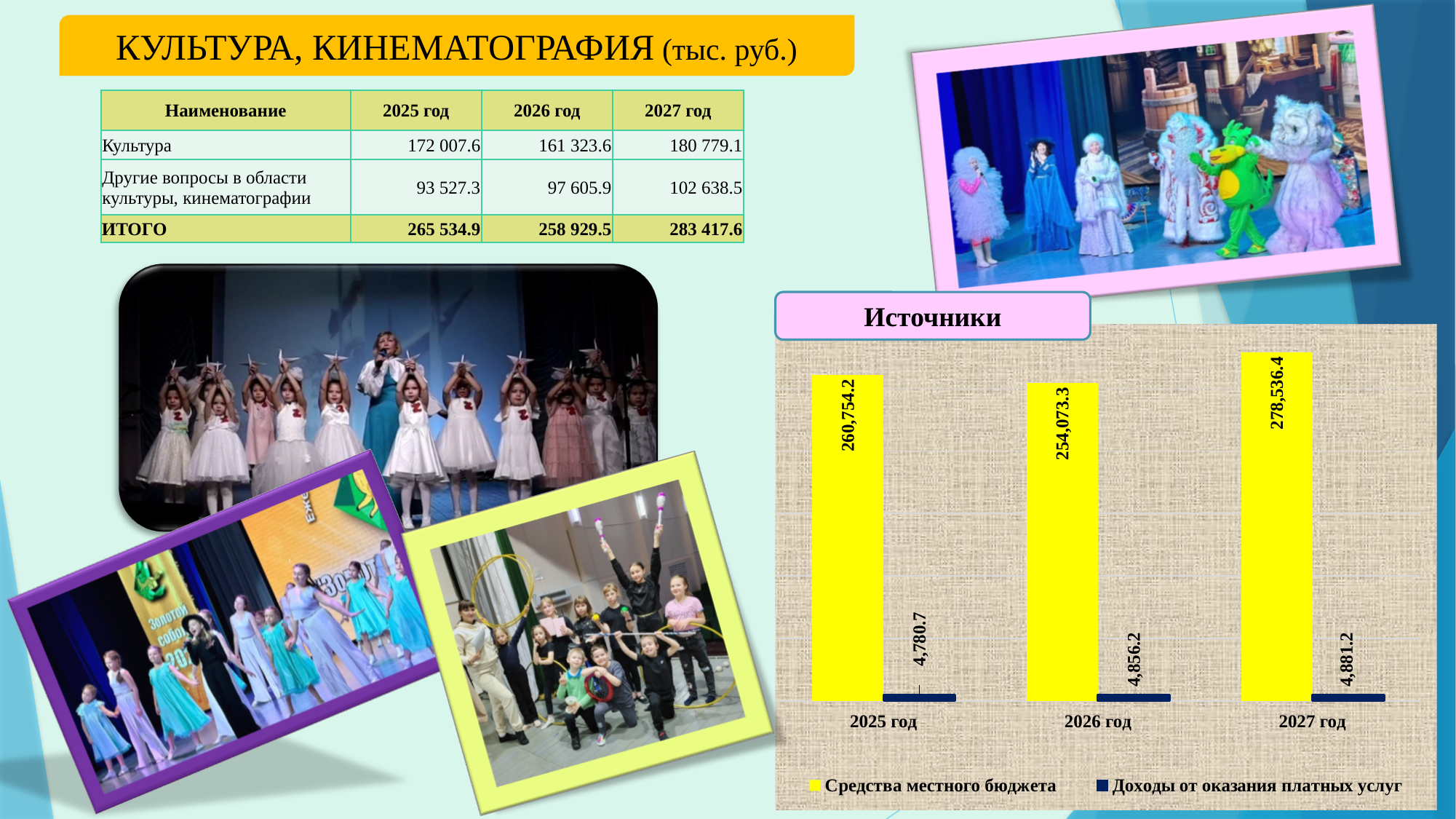
In the "Источники" chart, what is the difference between "Средства местного бюджета" in 2027 год and 2026 год? 24,463.1 In the "Источники" chart, what is the value of "Доходы от оказания платных услуг" for 2026 год? 4,856.2 In the "Источники" chart, which year has the highest value for "Средства местного бюджета"? 2027 год In the "Источники" chart, which year has the lowest value for "Средства местного бюджета"? 2026 год In the "Источники" chart, what is the value of "Доходы от оказания платных услуг" for 2025 год? 4,780.7 What kind of chart is shown under the heading "Источники"? bar chart In the "Источники" chart, which is larger: "Средства местного бюджета" in 2025 год or in 2026 год? 2025 год How many series does the legend of the "Источники" chart list? 2 In the "Источники" chart, what is the value of "Средства местного бюджета" for 2027 год? 278,536.4 How many years are shown on the x axis of the "Источники" chart? 3 In the "Источники" chart, what is the difference between "Доходы от оказания платных услуг" in 2027 год and 2025 год? 100.5 In the "Источники" chart, what is the value of "Средства местного бюджета" for 2025 год? 260,754.2